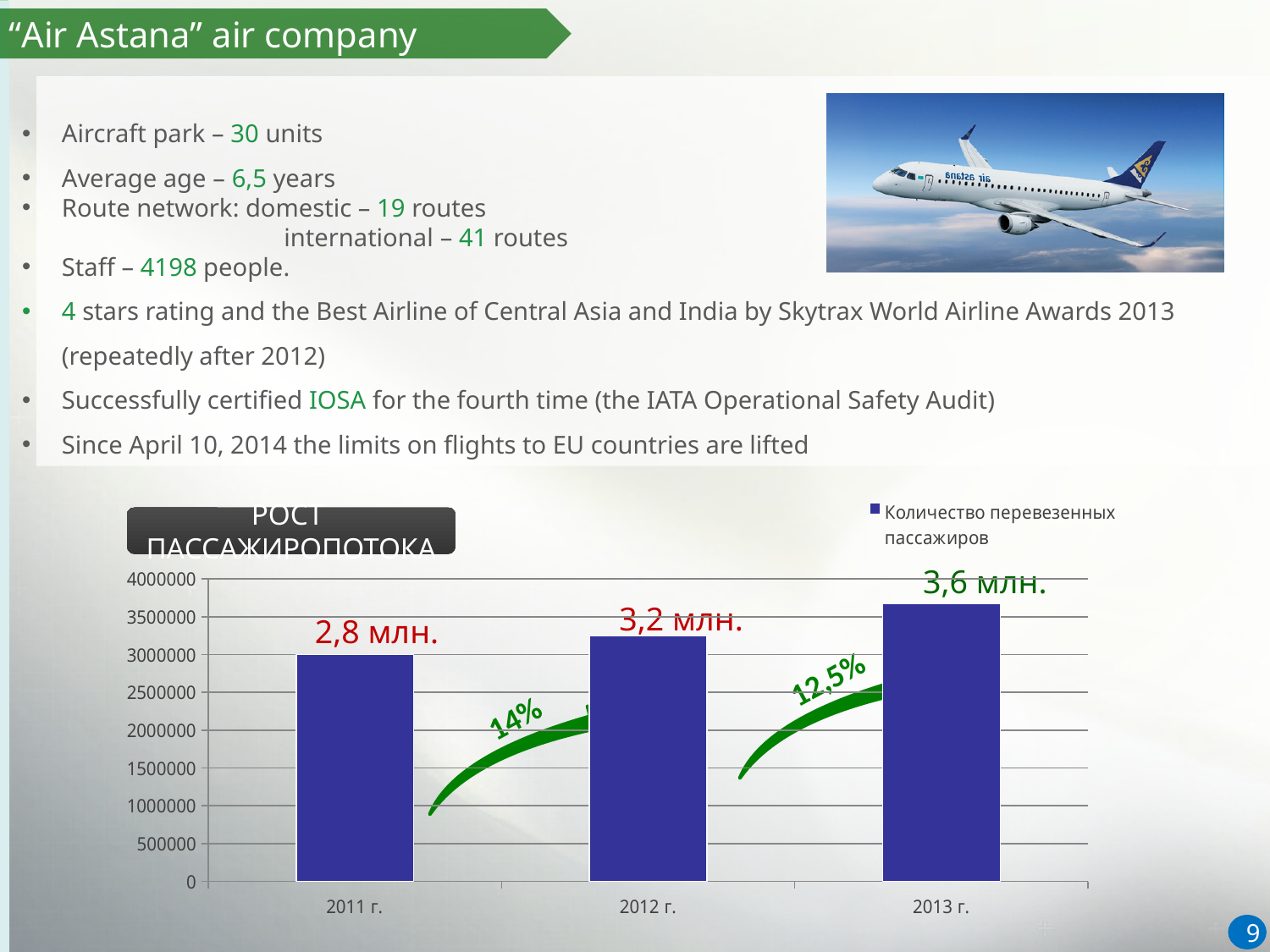
Which year has the lowest number of passengers carried? 2011 г. Which year has the highest number of passengers carried? 2013 г. How many series does the chart legend list? 1 How many years (categories) are shown on the x axis of the chart? 3 Is the value for 2013 г. greater or less than 3500000? greater Do the values rise or fall from 2011 г. to 2013 г.? rise What is the data label on the bar for 2011 г.? 2,8 млн. What is the data label on the bar for 2012 г.? 3,2 млн. What type of chart is shown on the slide? bar chart What is the series name shown in the chart legend? Количество перевезенных пассажиров What is the data label on the bar for 2013 г.? 3,6 млн.